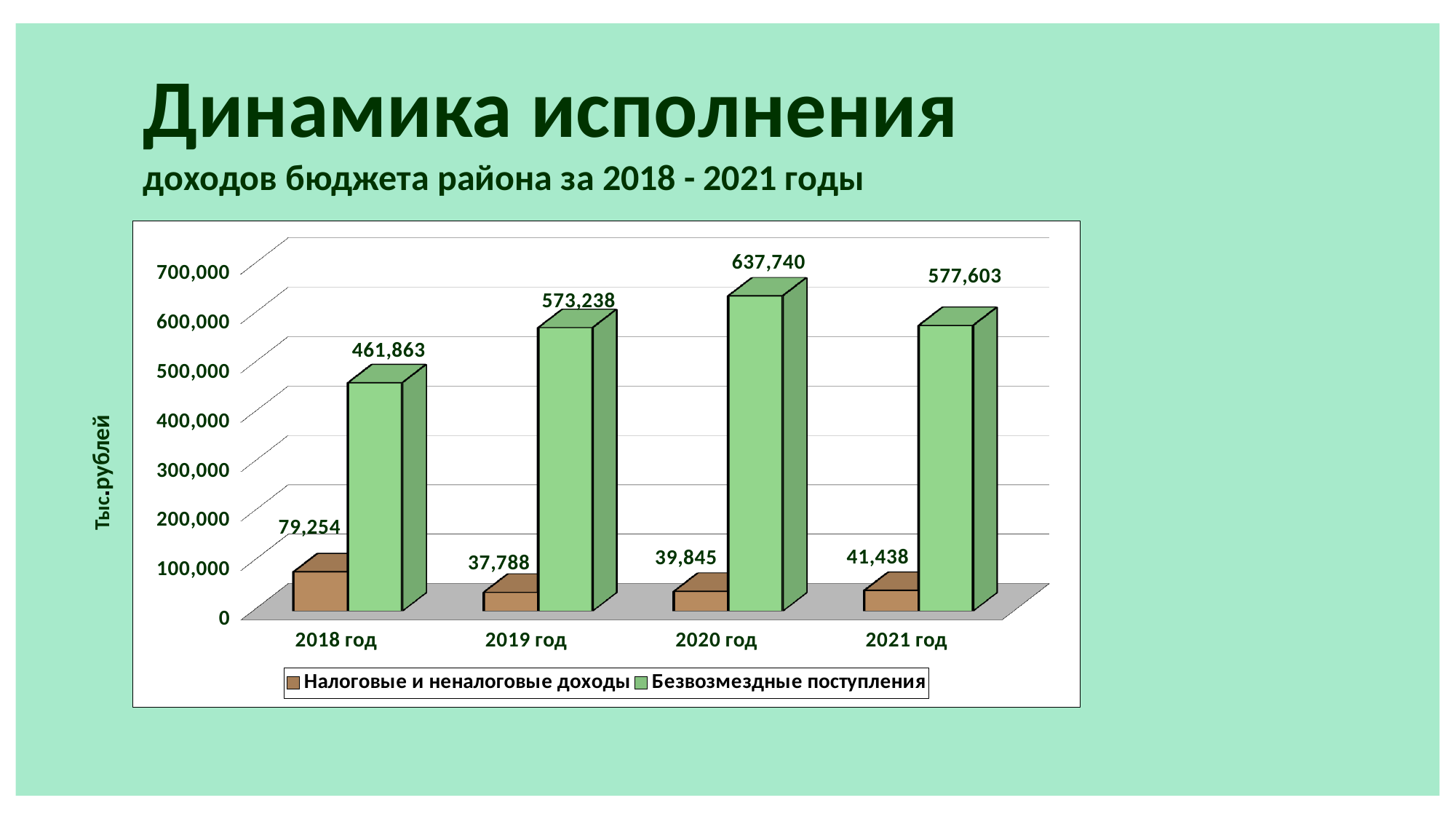
What is the value of Безвозмездные поступления for 2021 год? 577,603 What is the label of the vertical axis? Тыс.рублей What is the value of Безвозмездные поступления for 2020 год? 637,740 In which year is Налоговые и неналоговые доходы lowest? 2019 год What is the difference between Безвозмездные поступления in 2020 год and 2019 год? 64,502 In which year is Безвозмездные поступления highest? 2020 год How many series does the legend list? 2 What kind of chart is shown on the slide? Bar chart How many years are shown on the x axis? 4 What is the value of Налоговые и неналоговые доходы for 2019 год? 37,788 What is the value of Налоговые и неналоговые доходы for 2018 год? 79,254 Which is larger: Налоговые и неналоговые доходы in 2020 год or in 2021 год? 2021 год